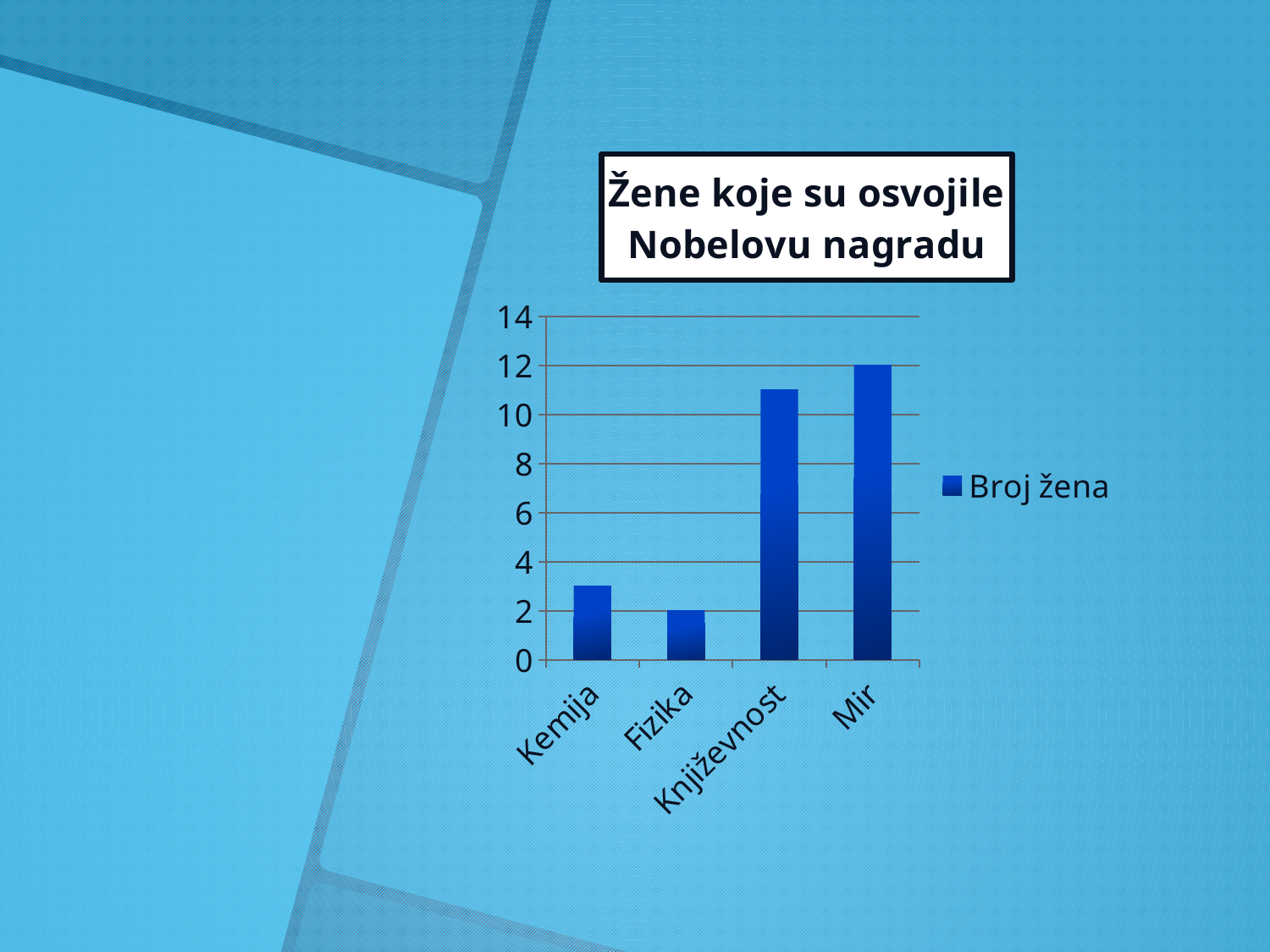
What is the difference between the values for Mir and Fizika? 10 Which category has the lowest value? Fizika What is the title of the chart? Žene koje su osvojile Nobelovu nagradu What is the value for Mir? 12 What kind of chart is shown on the slide? bar chart What is the value for Fizika? 2 How many categories are shown on the x axis? 4 Is the value for Kemija greater or less than 4? less Is the value for Književnost greater or less than 10? greater Which category has the highest value? Mir Which is larger, the value for Književnost or the value for Kemija? Književnost How many series does the legend list? 1